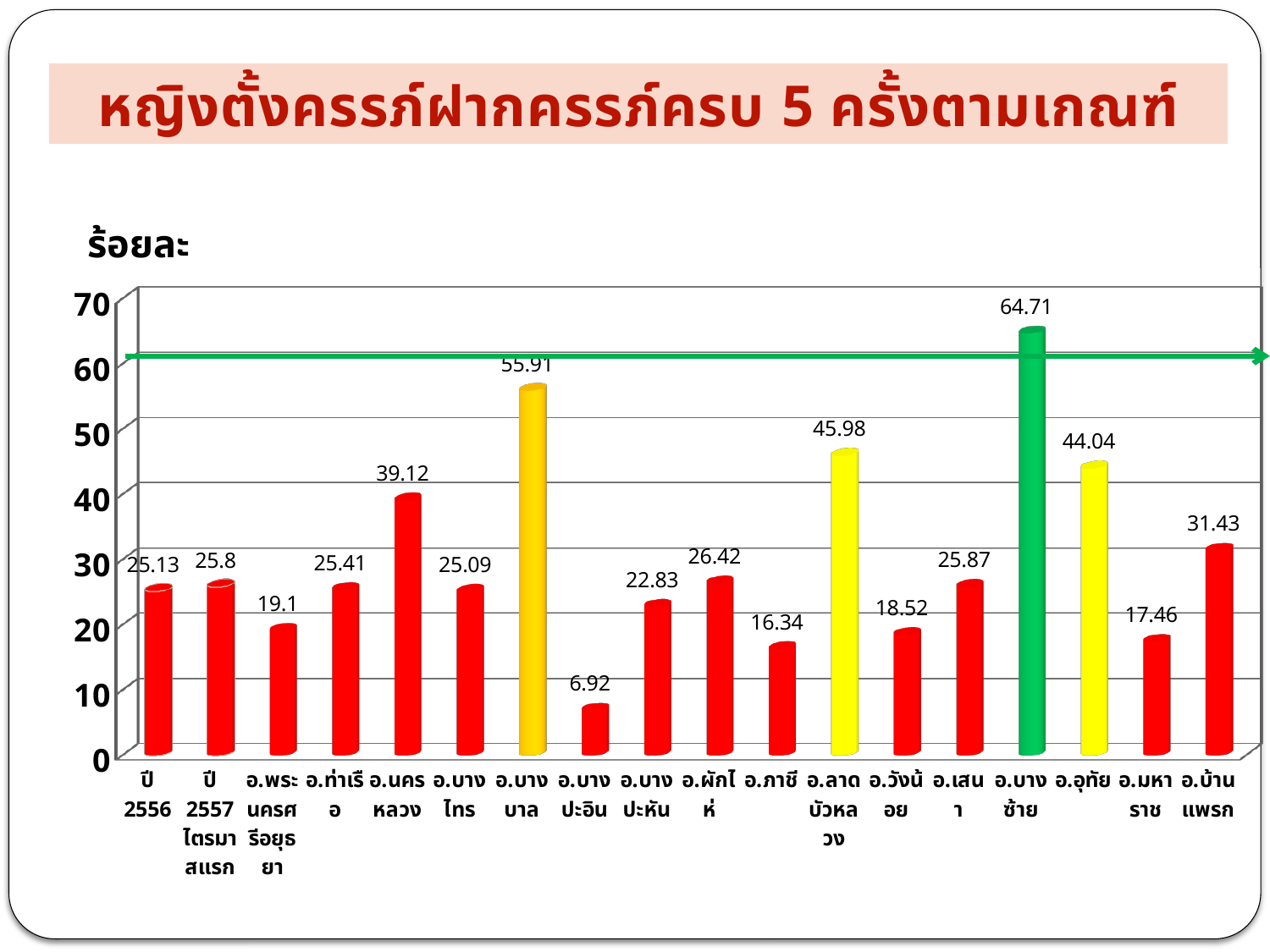
How many categories are shown on the x axis? 18 Which category has the lowest value? อ.บางปะอิน What is the value for อ.บางซ้าย? 64.71 Is the value for อ.บ้านแพรก greater or less than 30? greater Which category has the highest value? อ.บางซ้าย What type of chart is shown on the slide? bar chart What is the value for อ.บางบาล? 55.91 What is the title of the chart? ร้อยละ Which is larger, the value for อ.ลาดบัวหลวง or the value for อ.นครหลวง? อ.ลาดบัวหลวง What is the difference between the values for อ.บางซ้าย and อ.อุทัย? 20.67 What is the value for อ.บางปะอิน? 6.92 What is the value for ปี 2556? 25.13